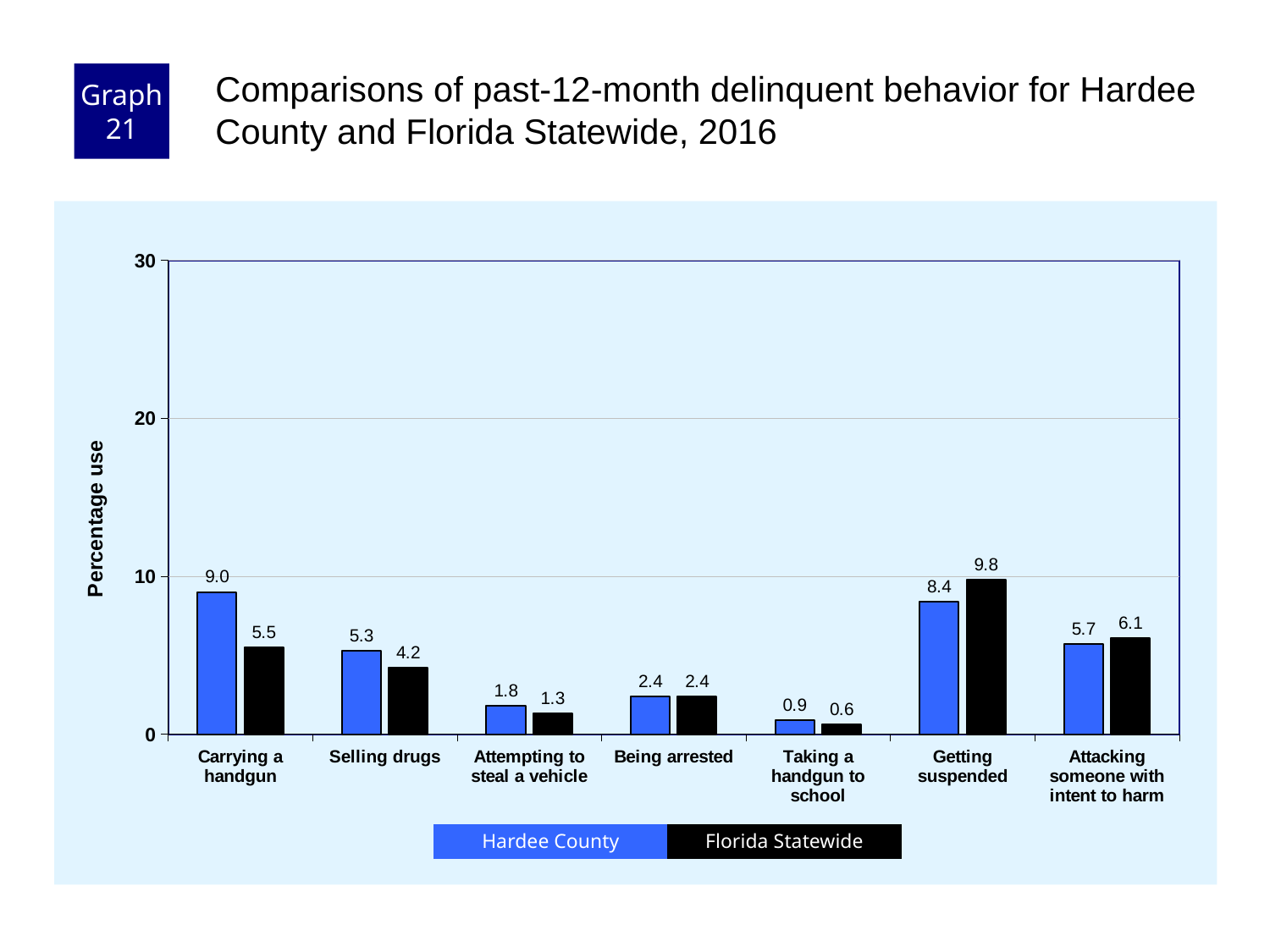
What is the difference between the Hardee County and Florida Statewide values for Carrying a handgun? 3.5 What is the label of the y axis? Percentage use What is the Hardee County value for Taking a handgun to school? 0.9 Is the Hardee County value for Getting suspended greater or less than 10? less How many categories are shown on the x axis? 7 Which category has the highest Florida Statewide value? Getting suspended What is the Hardee County value for Carrying a handgun? 9.0 Which is larger for Attacking someone with intent to harm, Hardee County or Florida Statewide? Florida Statewide Which category has the lowest Hardee County value? Taking a handgun to school How many series does the legend list? 2 What is the Florida Statewide value for Getting suspended? 9.8 What kind of chart is shown on the slide? bar chart